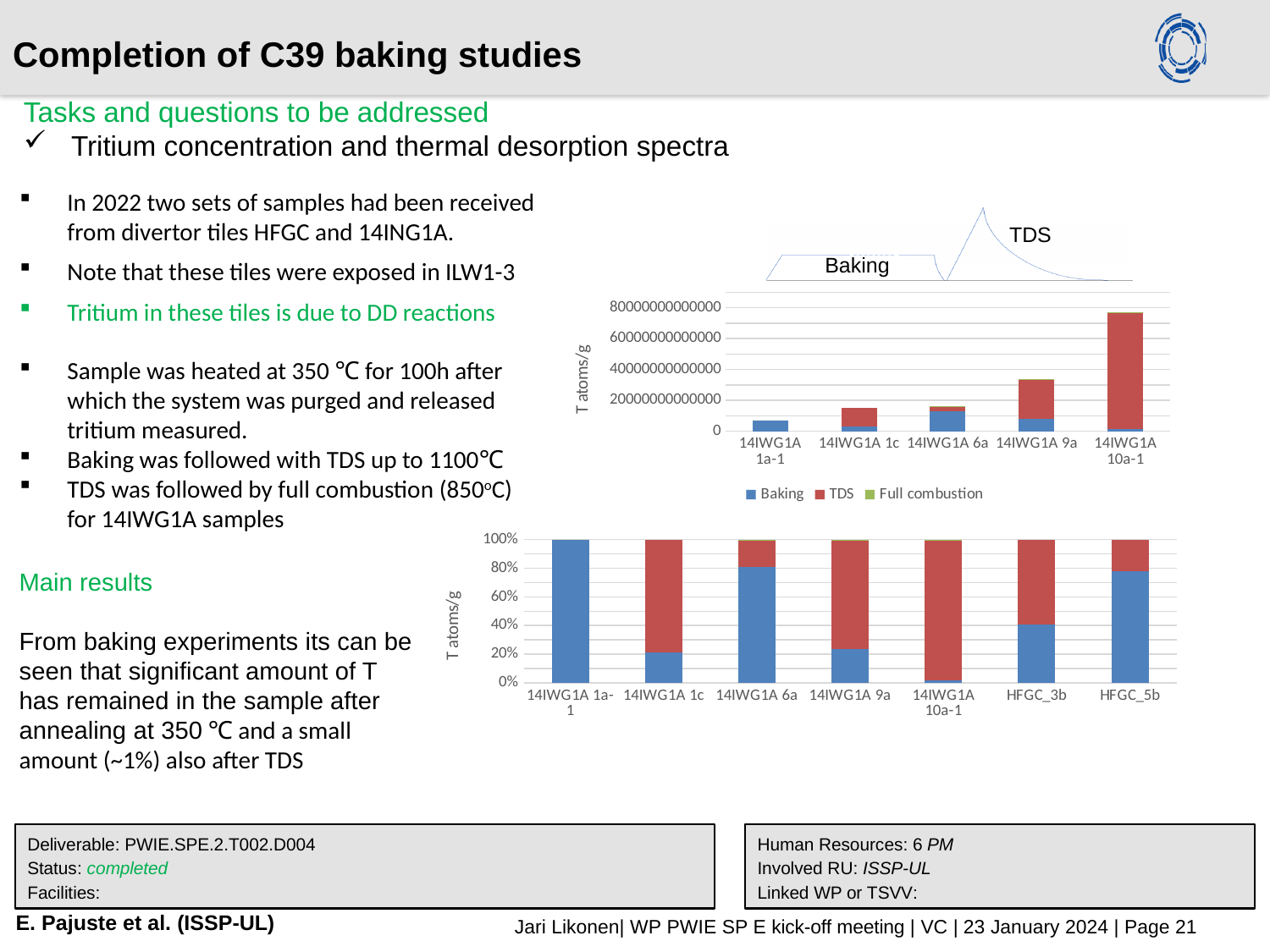
What is the y axis label of the bottom chart? T atoms/g In the top chart, which category has the lowest total bar? 14IWG1A 1a-1 How many categories are shown on the x axis of the bottom chart? 7 In the top chart, is the total value for 14IWG1A 10a-1 greater or less than 60000000000000? greater In the bottom chart, which has the larger Baking share, 14IWG1A 6a or 14IWG1A 1c? 14IWG1A 6a In the top chart, which category has the highest total bar? 14IWG1A 10a-1 In the bottom chart, is the Baking share for 14IWG1A 6a greater or less than 60%? greater In the top chart, is the total value for 14IWG1A 9a greater or less than 20000000000000? greater How many series does the legend list for the charts? 3 What kind of chart is the top chart on the slide? bar chart How many categories are shown on the x axis of the top chart? 5